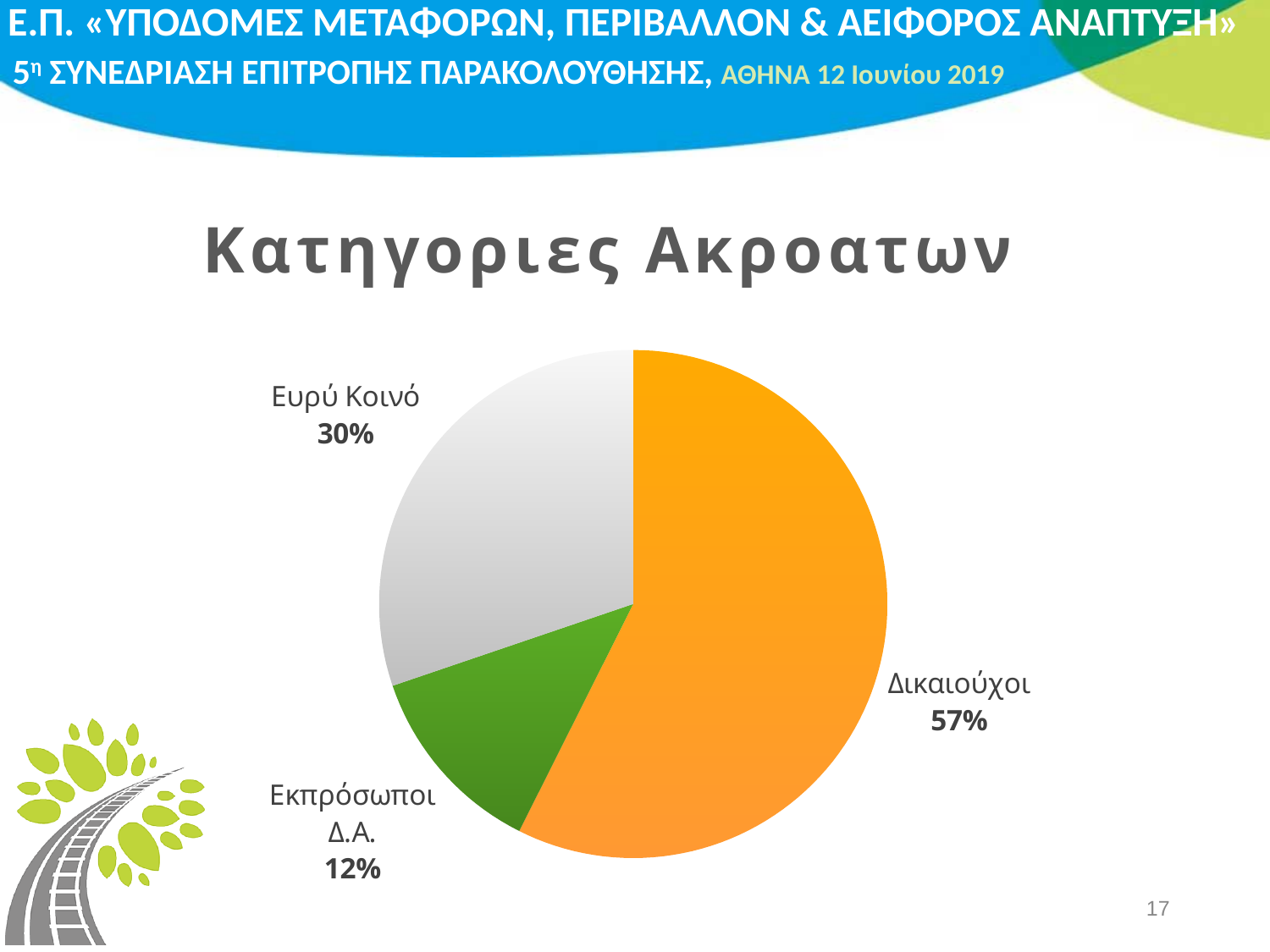
What colour is the slice for Δικαιούχοι? orange What is the title of the chart? Κατηγοριες Ακροατων What is the difference in percentage points between Ευρύ Κοινό and Εκπρόσωποι Δ.Α.? 18 Which is larger, the share for Ευρύ Κοινό or the share for Εκπρόσωποι Δ.Α.? Ευρύ Κοινό Which category has the smallest slice of the pie? Εκπρόσωποι Δ.Α. What share of the pie does Ευρύ Κοινό represent? 30% What share of the pie does Εκπρόσωποι Δ.Α. represent? 12% How many categories are shown in the pie chart? 3 What share of the pie does Δικαιούχοι represent? 57% What type of chart is shown on the slide? pie chart Which category has the largest slice of the pie? Δικαιούχοι What is the difference in percentage points between Δικαιούχοι and Ευρύ Κοινό? 27